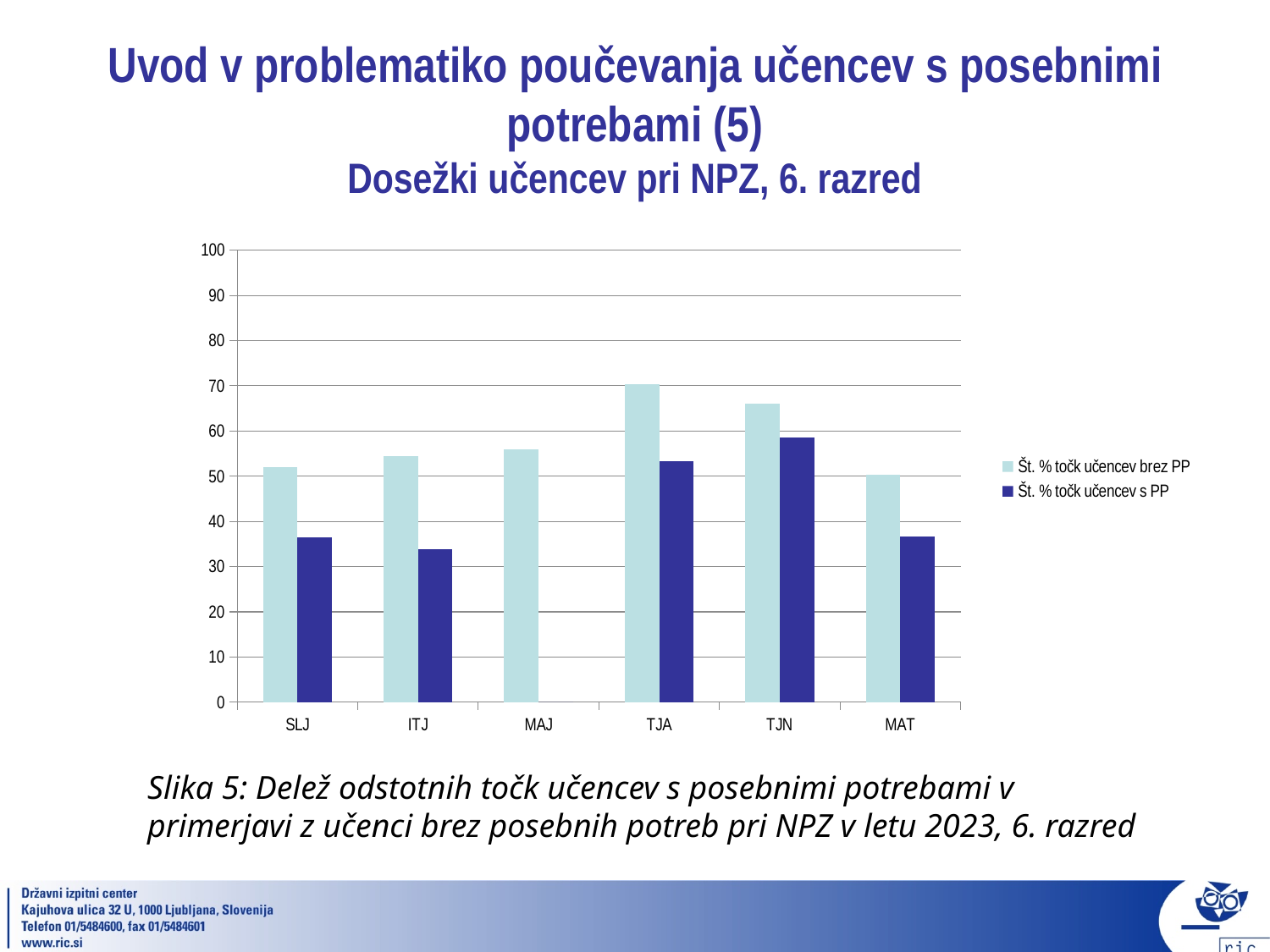
Is the value for MAJ in the series 'Št. % točk učencev brez PP' greater or less than 50? greater Which category has the highest value for the series 'Št. % točk učencev s PP'? TJN Is the value for TJA in the series 'Št. % točk učencev brez PP' greater or less than 60? greater How many series does the legend list? 2 Which category on the x axis has a bar for only one of the two series? MAJ For SLJ, which series has the larger value: 'Št. % točk učencev brez PP' or 'Št. % točk učencev s PP'? Št. % točk učencev brez PP In the series 'Št. % točk učencev brez PP', which is larger: TJA or TJN? TJA Which category has the highest value for the series 'Št. % točk učencev brez PP'? TJA Is the value for ITJ in the series 'Št. % točk učencev s PP' greater or less than 40? less How many categories are shown on the x axis of the chart? 6 What kind of chart is shown on the slide? bar chart